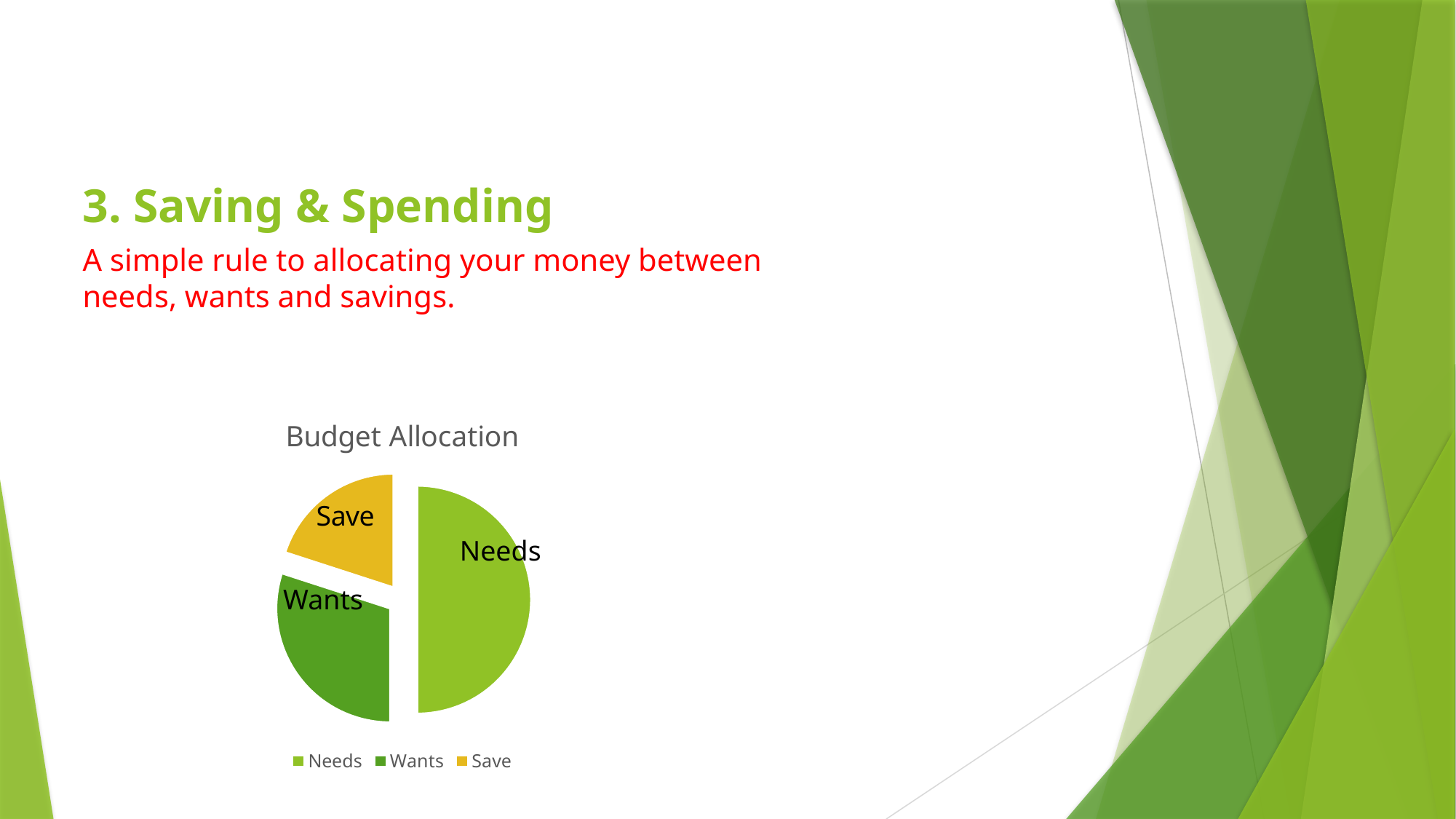
How many slices does the Budget Allocation pie chart have? 3 In the Budget Allocation chart, which slice is larger: Needs or Wants? Needs How many entries does the legend of the Budget Allocation chart list? 3 What kind of chart is shown on the slide? pie chart What are the three categories shown in the legend of the Budget Allocation chart? Needs, Wants, Save What is the title of the chart? Budget Allocation Which category has the smallest slice in the Budget Allocation pie chart? Save In the Budget Allocation chart, which slice is larger: Wants or Save? Wants Which category has the largest slice in the Budget Allocation pie chart? Needs